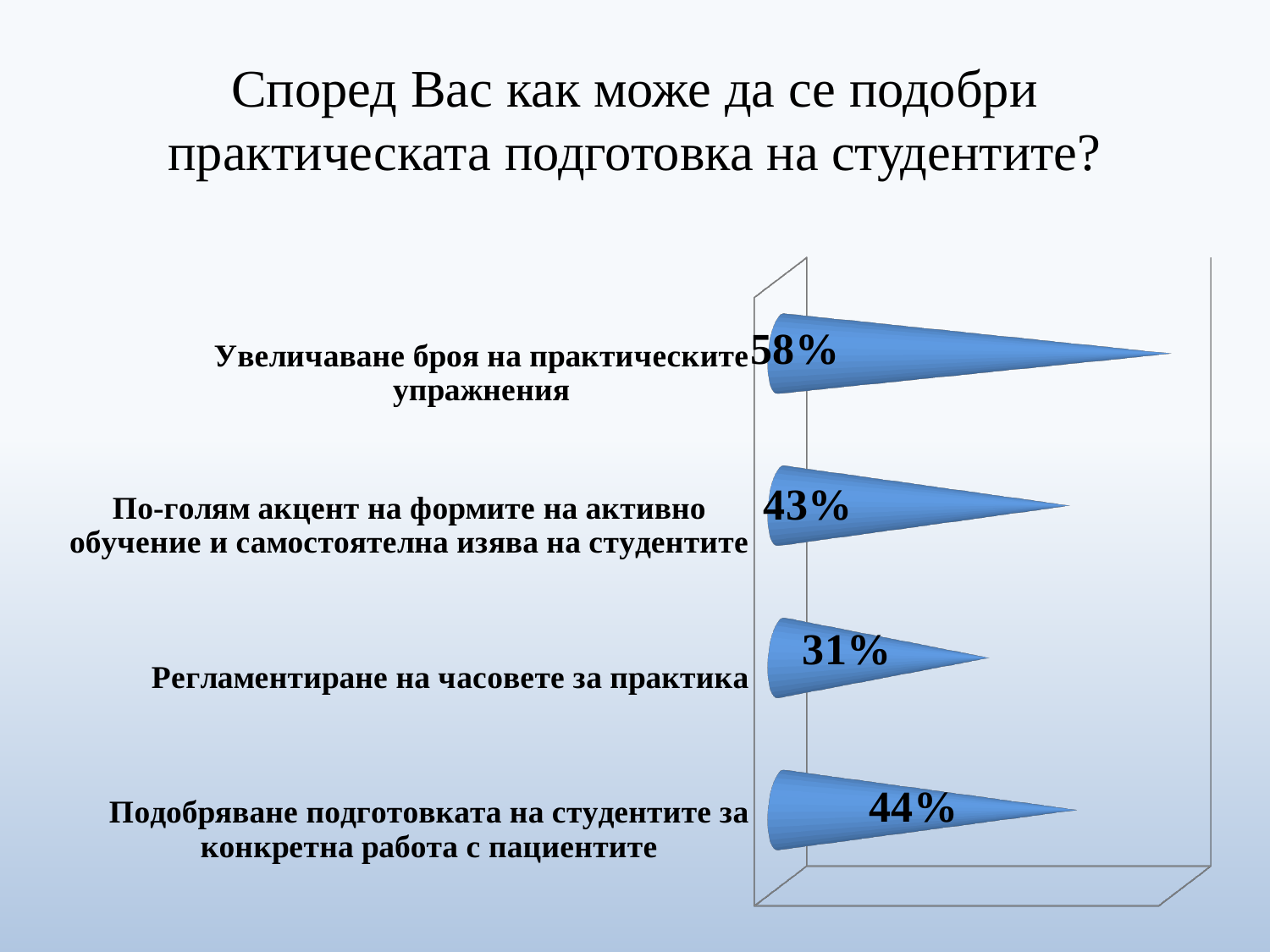
What is the value for "Увеличаване броя на практическите упражнения"? 58% Which is larger: the value for "Увеличаване броя на практическите упражнения" or the value for "Подобряване подготовката на студентите за конкретна работа с пациентите"? Увеличаване броя на практическите упражнения What is the difference between the values for "Увеличаване броя на практическите упражнения" and "Регламентиране на часовете за практика"? 27% What is the value for "Регламентиране на часовете за практика"? 31% How many categories are shown in the chart? 4 What is the value for "По-голям акцент на формите на активно обучение и самостоятелна изява на студентите"? 43% Which category has the highest value? Увеличаване броя на практическите упражнения What is the title of the slide? Според Вас как може да се подобри практическата подготовка на студентите? What kind of chart is shown on the slide? Bar chart What is the difference between the values for "Подобряване подготовката на студентите за конкретна работа с пациентите" and "По-голям акцент на формите на активно обучение и самостоятелна изява на студентите"? 1% What is the value for "Подобряване подготовката на студентите за конкретна работа с пациентите"? 44% Which category has the lowest value? Регламентиране на часовете за практика